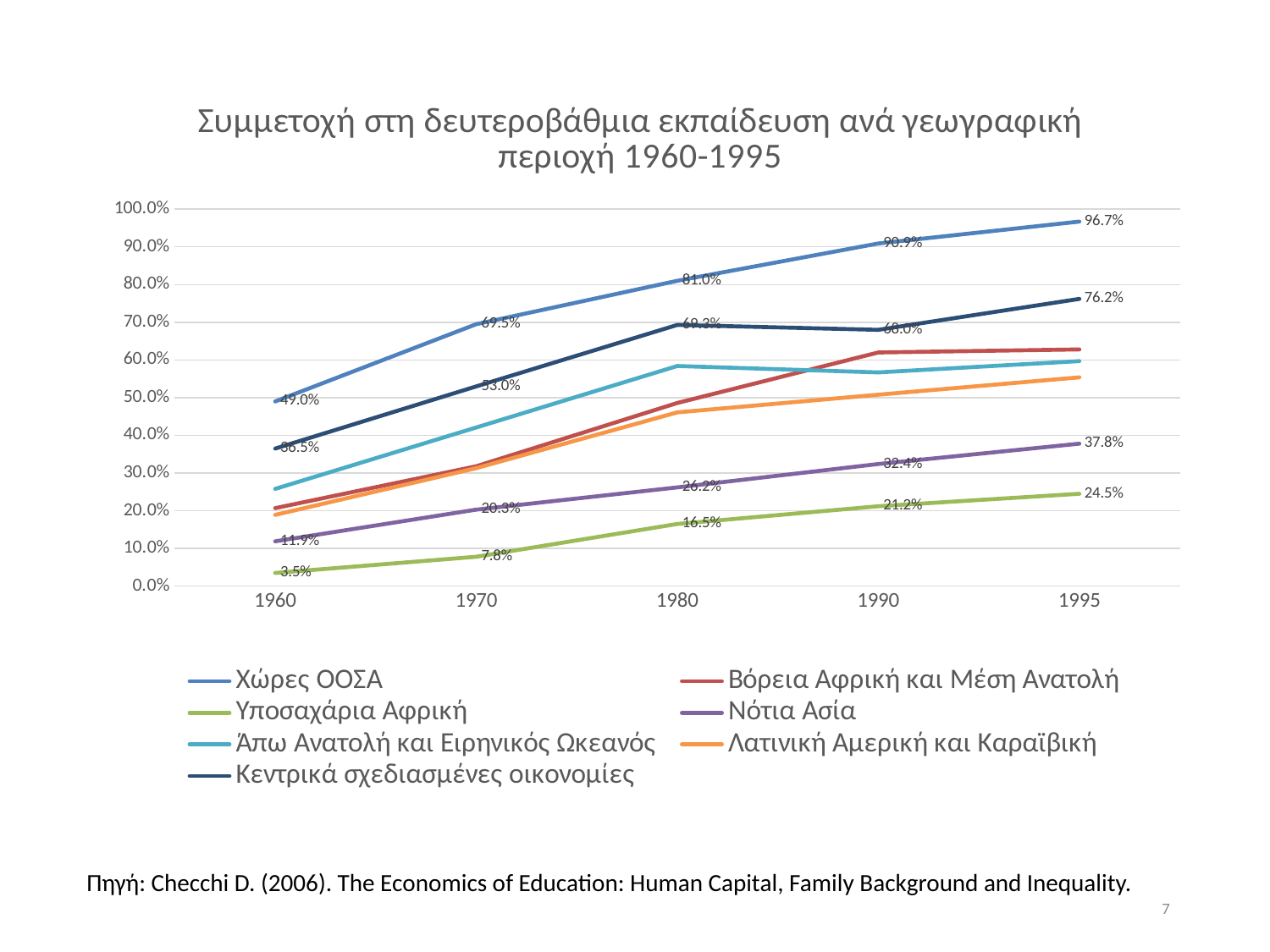
What is the value for Υποσαχάρια Αφρική in 1960? 3.5% What is the value for Νότια Ασία in 1995? 37.8% Which region has the highest value in 1995? Χώρες ΟΟΣΑ Which is larger in 1990, the value for Νότια Ασία or the value for Υποσαχάρια Αφρική? Νότια Ασία How many series does the legend list? 7 Is the value for Λατινική Αμερική και Καραϊβική in 1995 greater or less than 50.0%? greater What is the value for Χώρες ΟΟΣΑ in 1995? 96.7% What kind of chart is shown on the slide? Line chart What is the value for Κεντρικά σχεδιασμένες οικονομίες in 1995? 76.2% By how many percentage points did the value for Χώρες ΟΟΣΑ increase from 1960 to 1995? 47.7 percentage points How many years are shown on the x axis? 5 Which region has the lowest value in 1995? Υποσαχάρια Αφρική